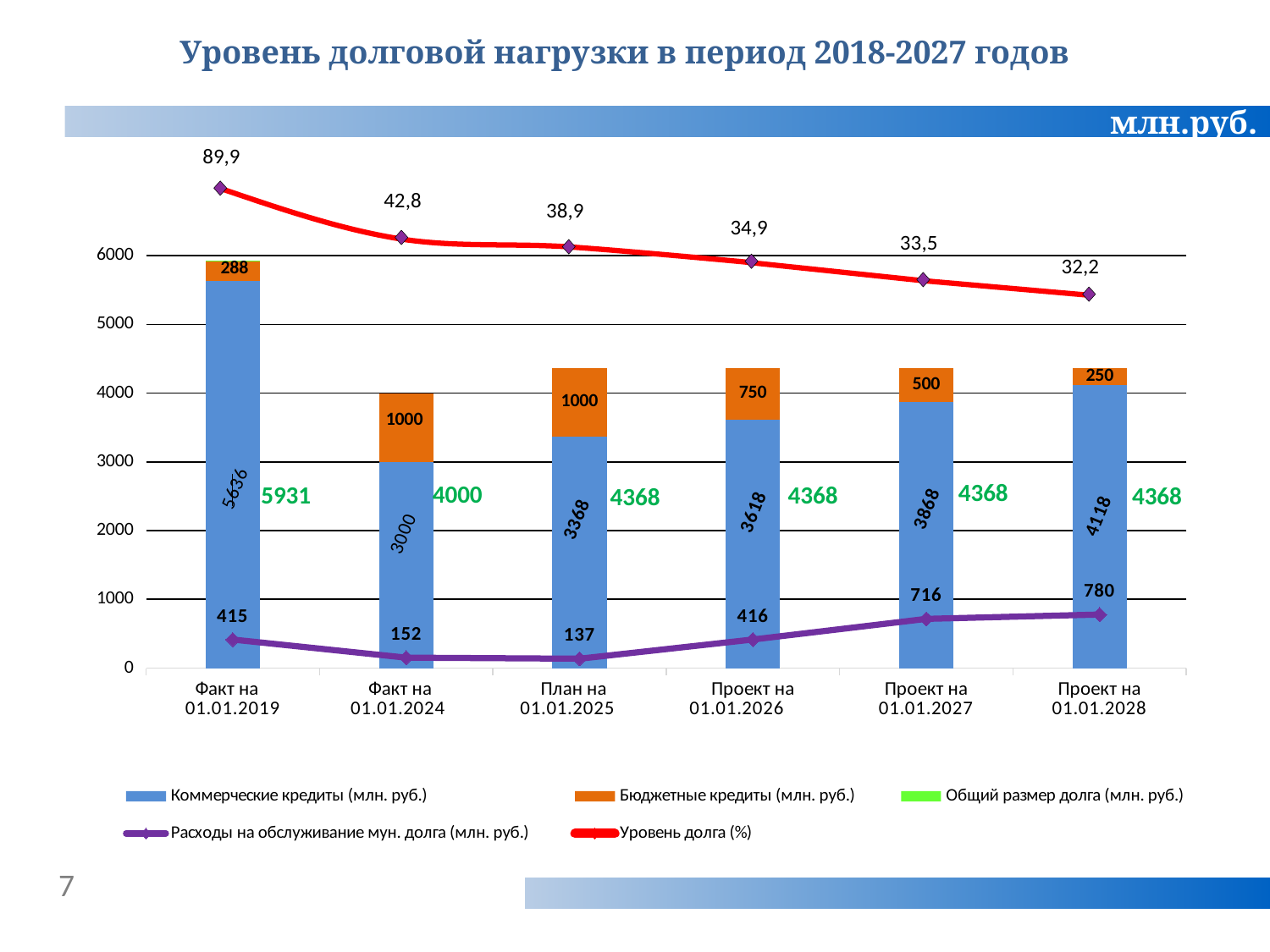
How many series does the legend list? 5 How many categories are shown on the x axis? 6 What is the total debt (Общий размер долга) label shown for Факт на 01.01.2024? 4000 What is the value of Расходы на обслуживание мун. долга (млн. руб.) for Проект на 01.01.2027? 716 What is the value of Коммерческие кредиты (млн. руб.) for Проект на 01.01.2028? 4118 What is the difference in Уровень долга (%) between Факт на 01.01.2019 and Факт на 01.01.2024? 47,1 What is the value of Уровень долга (%) for Факт на 01.01.2019? 89,9 Does Уровень долга (%) rise or fall from Факт на 01.01.2019 to Проект на 01.01.2028? fall Which is larger: Бюджетные кредиты for Проект на 01.01.2026 or for Проект на 01.01.2027? Проект на 01.01.2026 Which category has the highest value of Коммерческие кредиты (млн. руб.)? Факт на 01.01.2019 Which category has the lowest value of Расходы на обслуживание мун. долга (млн. руб.)? План на 01.01.2025 What is the value of Бюджетные кредиты (млн. руб.) for План на 01.01.2025? 1000